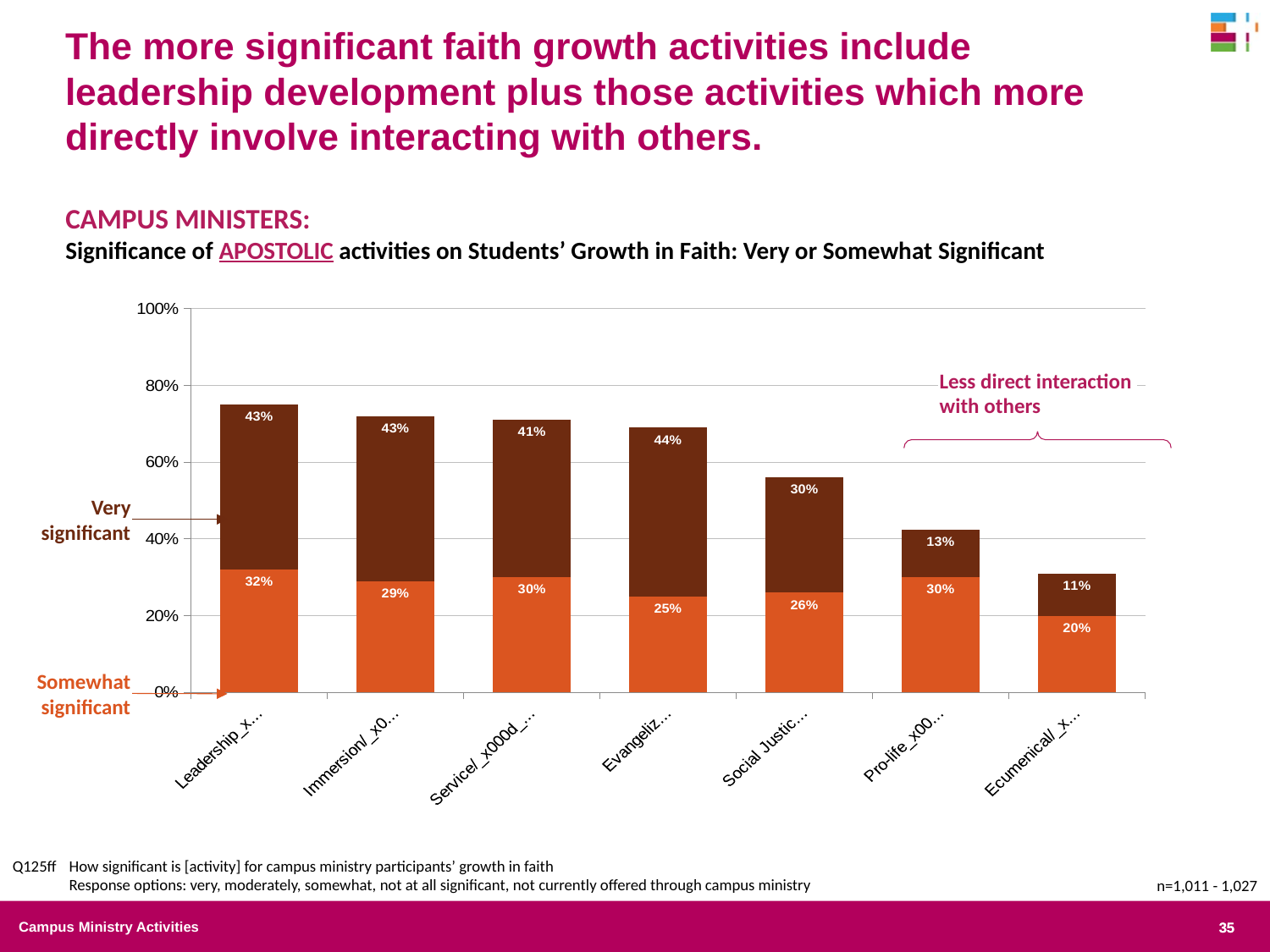
What percentage of campus ministers rated Ecumenical activities as somewhat significant? 20% What percentage of campus ministers rated Leadership as very significant? 43% What type of chart is used on this slide? Stacked bar chart What is the combined (very plus somewhat significant) total for Leadership? 75% What is the combined total of the stacked bar for Ecumenical? 31% Which activity has the highest 'somewhat significant' percentage? Leadership For Social Justice, which is larger: the 'very significant' or the 'somewhat significant' share? Very significant What is the 'somewhat significant' value for Pro-life? 30% Do the total bar heights rise or fall moving from left to right across the chart? Fall How many activities are shown on the x axis of the chart? 7 Which activity has the lowest 'very significant' percentage? Ecumenical How many percentage points higher is the 'very significant' value for Leadership than for Pro-life? 30%